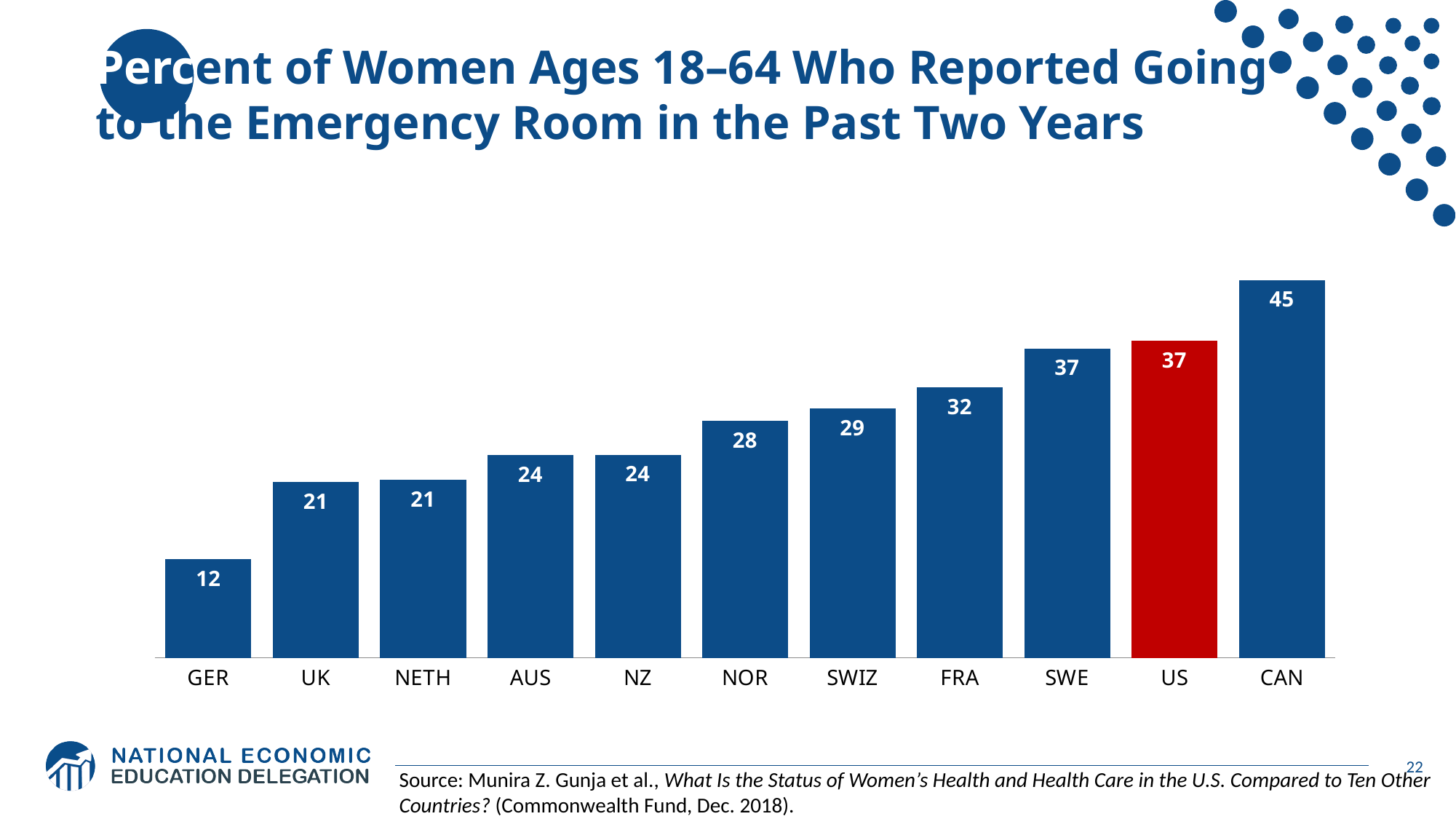
Do the values rise or fall from left to right along the x axis? Rise Which country's bar is coloured red? US Which country has the lowest value? GER Which country has the highest value? CAN What is the value for GER? 12 What is the difference between the values for CAN and the US? 8 What kind of chart is shown on the slide? Bar chart What is the value for the US? 37 Which is larger, the value for SWIZ or the value for AUS? SWIZ What is the difference between the values for FRA and UK? 11 What is the value for NOR? 28 How many countries are shown on the chart? 11